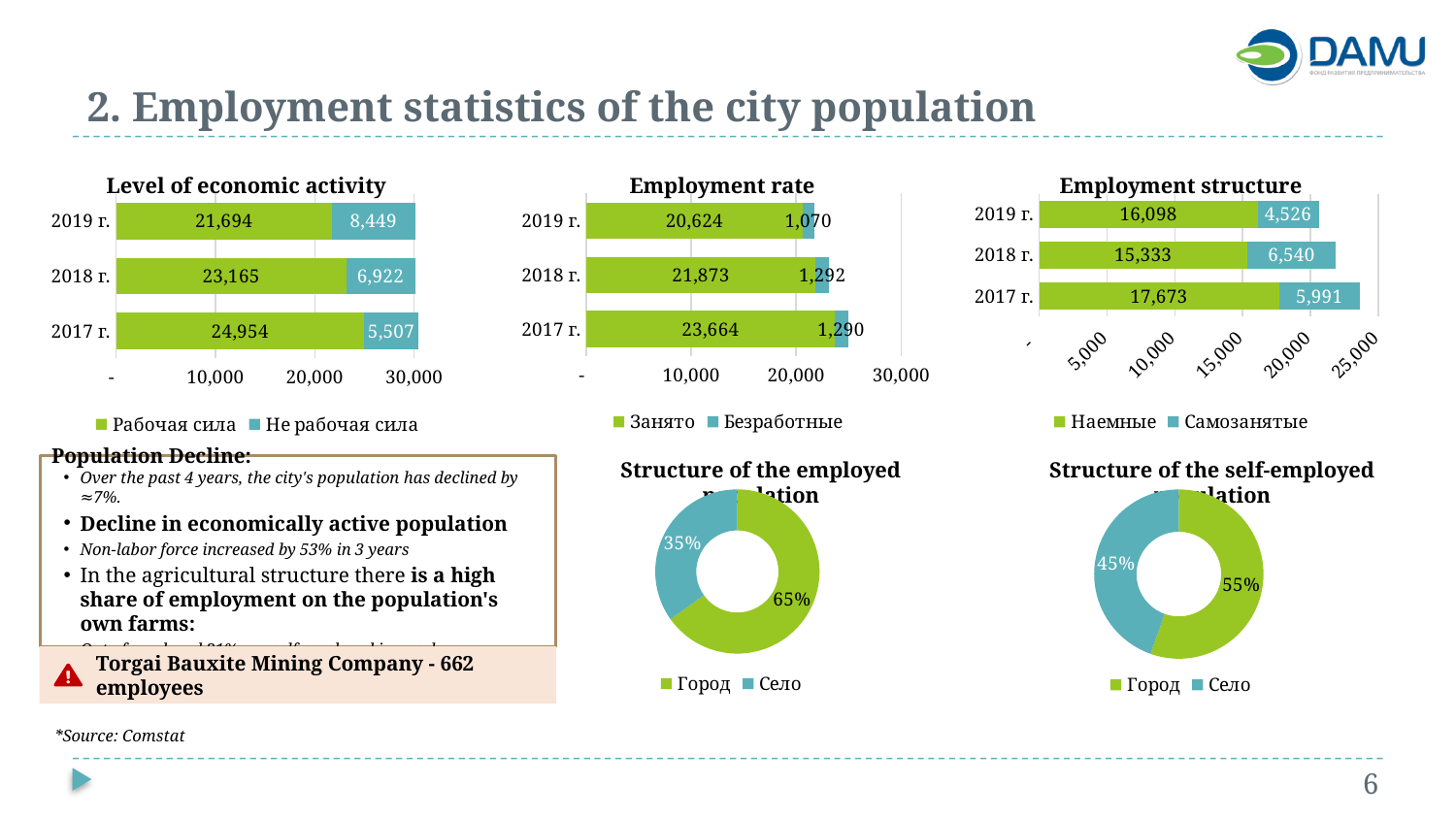
In the 'Employment structure' chart, is the Наемные value for 2017 г. larger than the Наемные value for 2018 г.? Yes, 2017 г. (17,673) is larger In the 'Employment structure' chart, what is the value of Самозанятые for 2018 г.? 6,540 In the 'Level of economic activity' chart, what is the total of the stacked bar for 2019 г.? 30,143 In the 'Employment rate' chart, which year has the lowest value for Занято? 2019 г. In the 'Employment structure' chart, how many series does the legend list? 2 In the 'Employment rate' chart, what is the value of Безработные for 2018 г.? 1,292 In the 'Structure of the self-employed population' chart, what share does Село have? 45% In the 'Structure of the employed population' chart, what share does Город have? 65% In the 'Level of economic activity' chart, what is the value of Рабочая сила for 2017 г.? 24,954 In the 'Employment rate' chart, what is the difference between the Занято values for 2017 г. and 2019 г.? 3,040 In the 'Level of economic activity' chart, which year has the highest value for Не рабочая сила? 2019 г. What kind of chart is the 'Structure of the self-employed population' chart? Donut (pie) chart